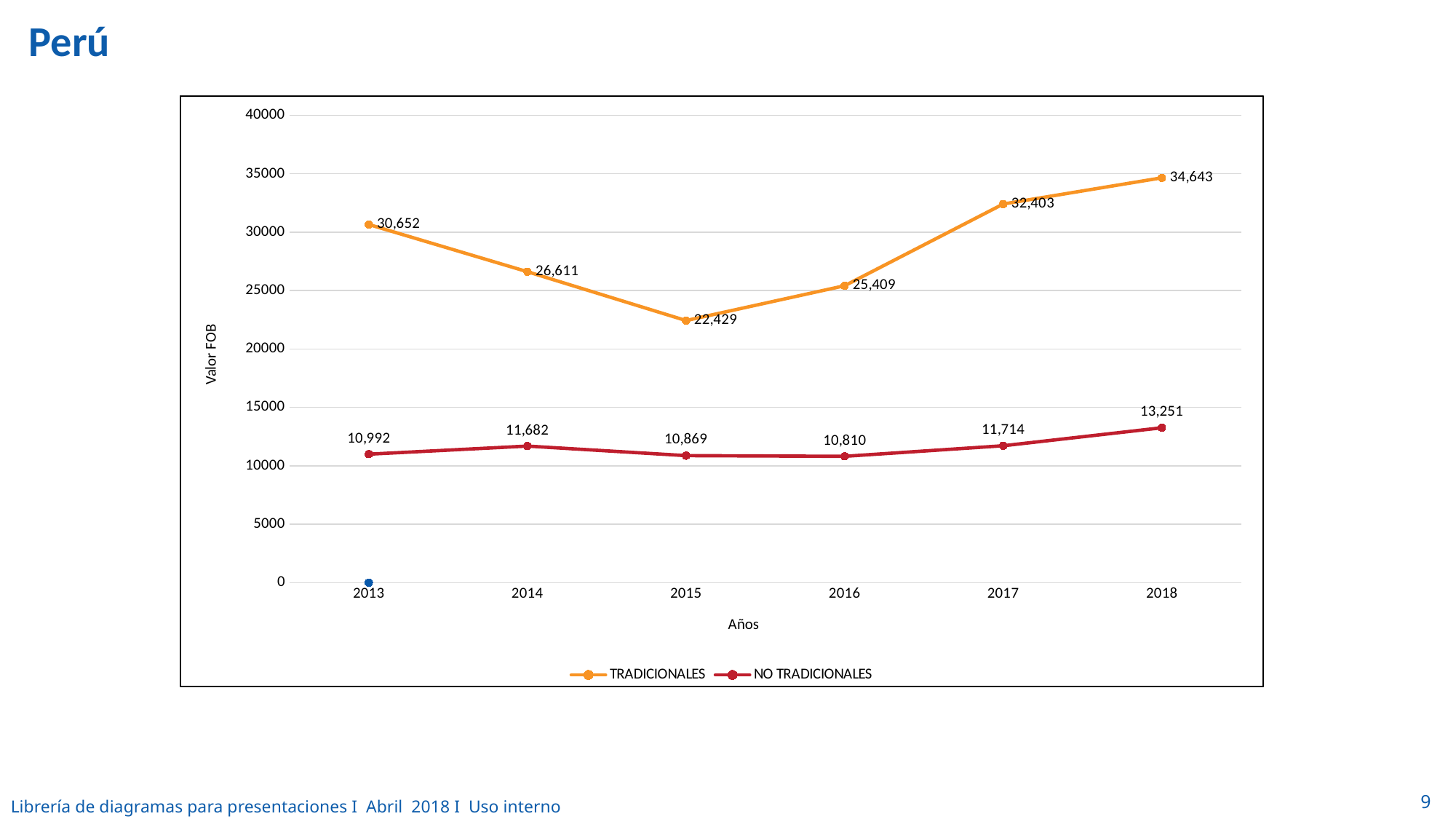
What is the difference between the TRADICIONALES values in 2018 and 2017? 2,240 What is the value for TRADICIONALES in 2013? 30,652 What is the value for NO TRADICIONALES in 2018? 13,251 How many series does the legend list? 2 What is the label of the y axis? Valor FOB Is the TRADICIONALES value for 2016 greater or less than 30000? less What kind of chart is shown on the slide? line chart What is the value for TRADICIONALES in 2015? 22,429 In which year is the TRADICIONALES value highest? 2018 How many years are shown on the x axis? 6 Which is larger, the NO TRADICIONALES value in 2014 or in 2017? 2017 In which year is the NO TRADICIONALES value lowest? 2016